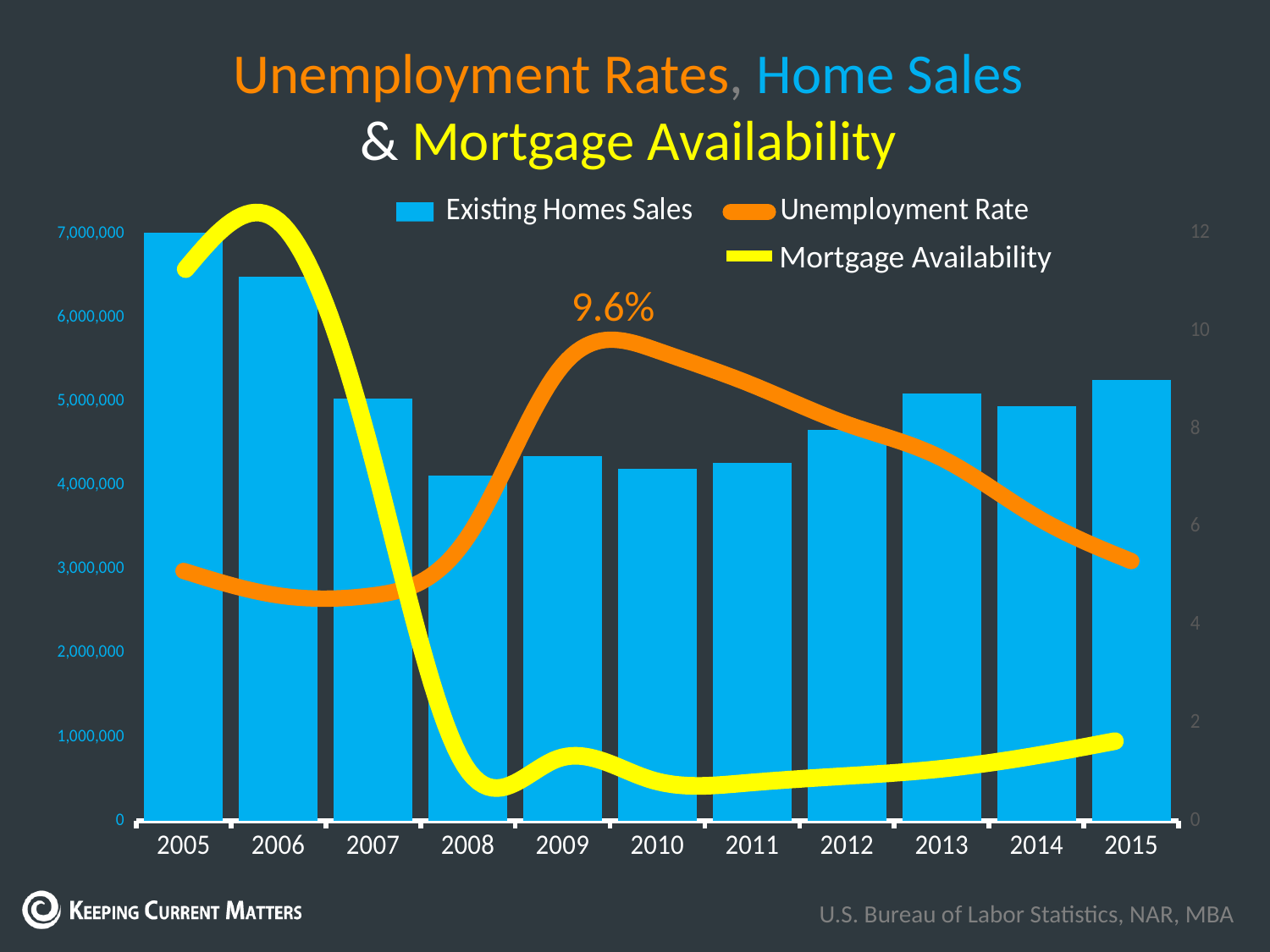
Which year has the highest Existing Homes Sales bar? 2005 Is the Existing Homes Sales value for 2008 greater or less than 5,000,000? less Is the Unemployment Rate for 2005 greater or less than 6 on the right axis? less What is the unemployment rate value labeled on the chart at its 2009 peak? 9.6% Does the Unemployment Rate line rise or fall from 2009 to 2015? fall How many years are shown on the x axis? 11 Is the Existing Homes Sales value for 2005 greater or less than 6,000,000? greater How many series does the legend list? 3 Which year has higher Existing Homes Sales, 2005 or 2015? 2005 Which year has higher Existing Homes Sales, 2006 or 2007? 2006 What kind of chart is this? Combined bar and line chart